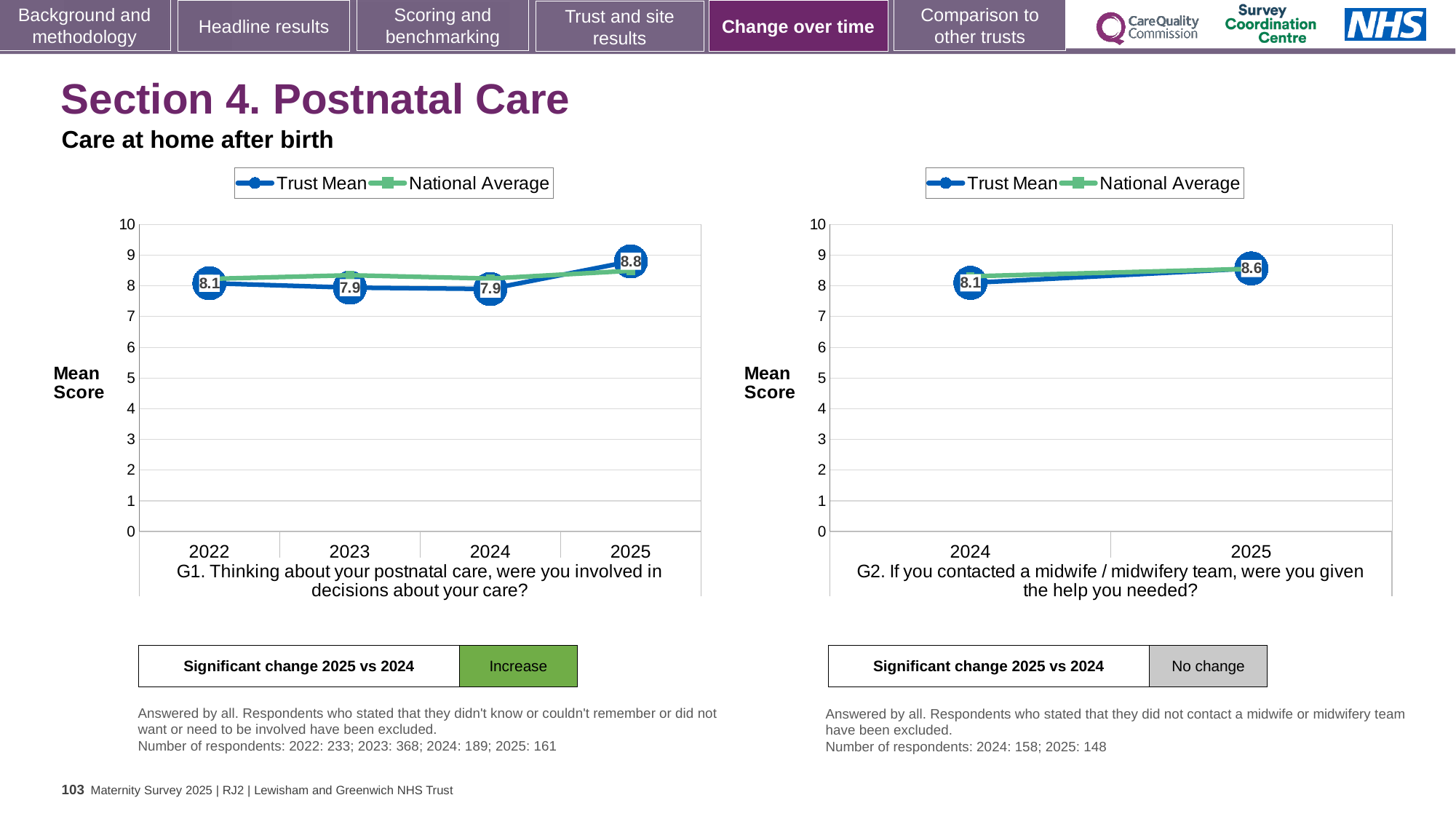
In the G2 chart on the right, what is the difference between the Trust Mean for 2025 and the Trust Mean for 2024? 0.5 In the G2 chart on the right, what is the Trust Mean for 2024? 8.1 How many years are plotted on the x axis of the G1 chart on the left? 4 What kind of chart is the G2 chart on the right? Line chart In the G1 chart on the left, what is the Trust Mean for 2025? 8.8 In the G2 chart on the right, what is the Trust Mean for 2025? 8.6 In the G1 chart on the left, is the Trust Mean for 2022 or for 2025 larger? 2025 In the G1 chart on the left, what is the Trust Mean for 2023? 7.9 How many series does the legend of the G2 chart on the right list? 2 In the G1 chart on the left, what is the difference between the Trust Mean for 2025 and the Trust Mean for 2024? 0.9 In the G1 chart on the left, which year has the highest Trust Mean? 2025 In the G1 chart on the left, what is the Trust Mean for 2022? 8.1